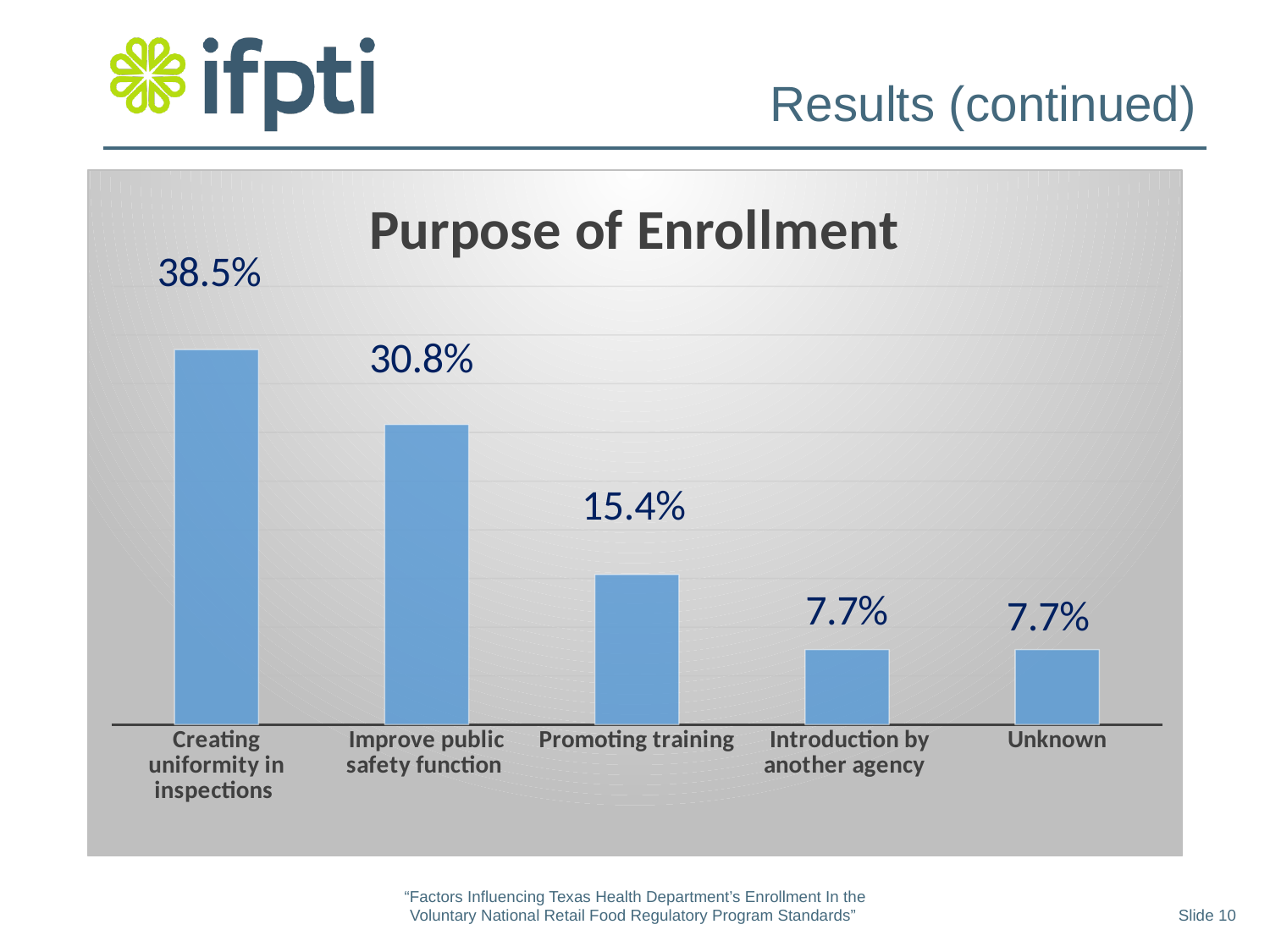
What is the value for Introduction by another agency? 7.7% Which category has the highest value? Creating uniformity in inspections What is the difference between Creating uniformity in inspections and Improve public safety function? 7.7% How many categories are shown in the chart? 5 What kind of chart is shown? Bar chart What is the title of the chart? Purpose of Enrollment What is the difference between Improve public safety function and Promoting training? 15.4% What is the value for Promoting training? 15.4% What is the value for Creating uniformity in inspections? 38.5% What is the value for Improve public safety function? 30.8% Do the values rise or fall from left to right across the categories? Fall Which is larger, Promoting training or Unknown? Promoting training